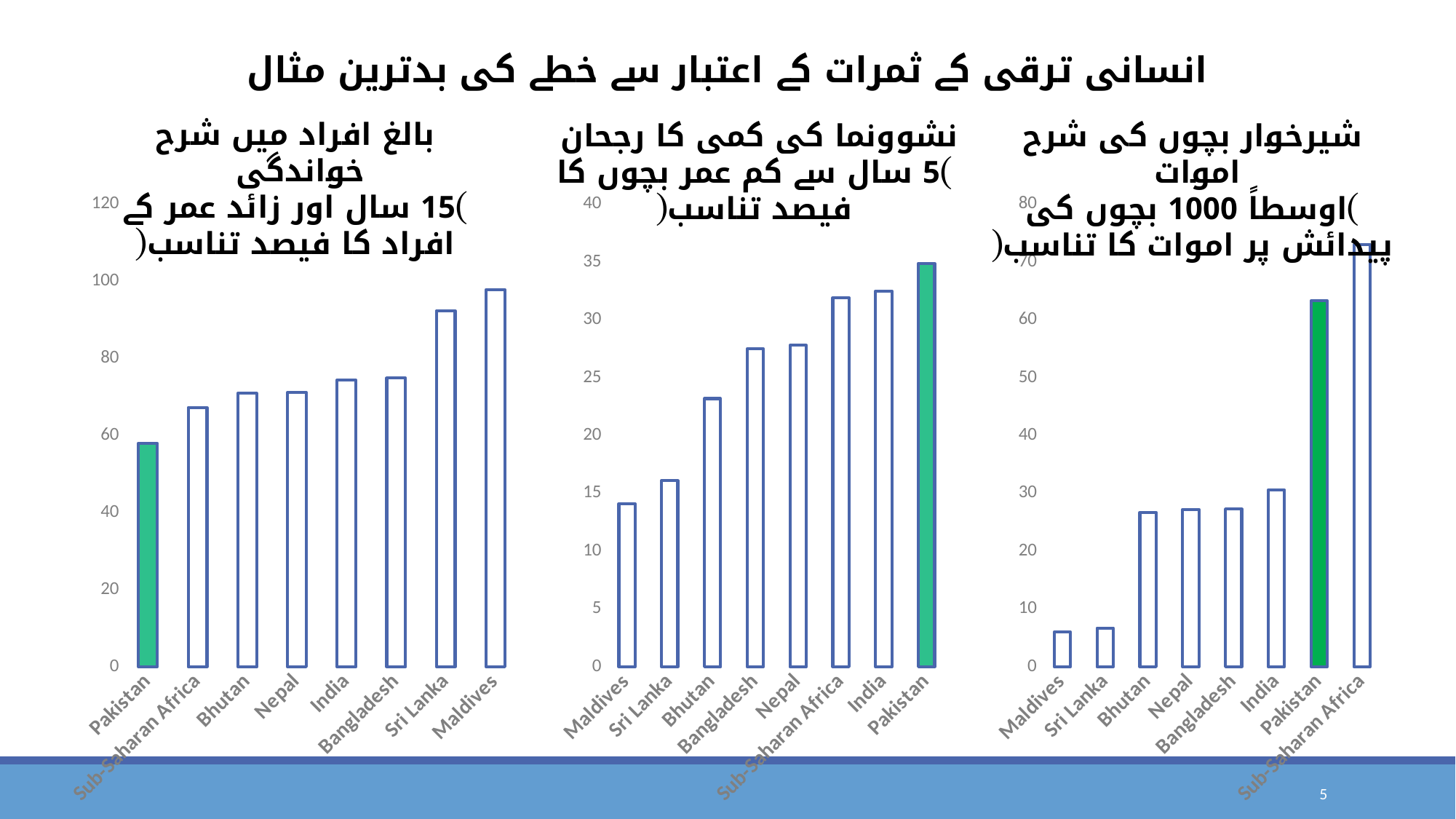
On the middle chart, is the value for Bhutan greater or less than 20? greater On the middle chart, which category has the lowest bar? Maldives On the left chart, is the value for Sri Lanka greater or less than 80? greater On the middle chart, which category has the highest bar? Pakistan On the left chart, is the value for Pakistan greater or less than 60? less On the right chart, which category's bar is filled in green? Pakistan How many countries or regions are shown on the left chart? 8 On the left chart, which category has the highest bar? Maldives On the left chart, which category has the lowest bar? Pakistan On the right chart, which is larger, the value for Pakistan or the value for India? Pakistan What kind of chart is the left chart on the slide? bar chart